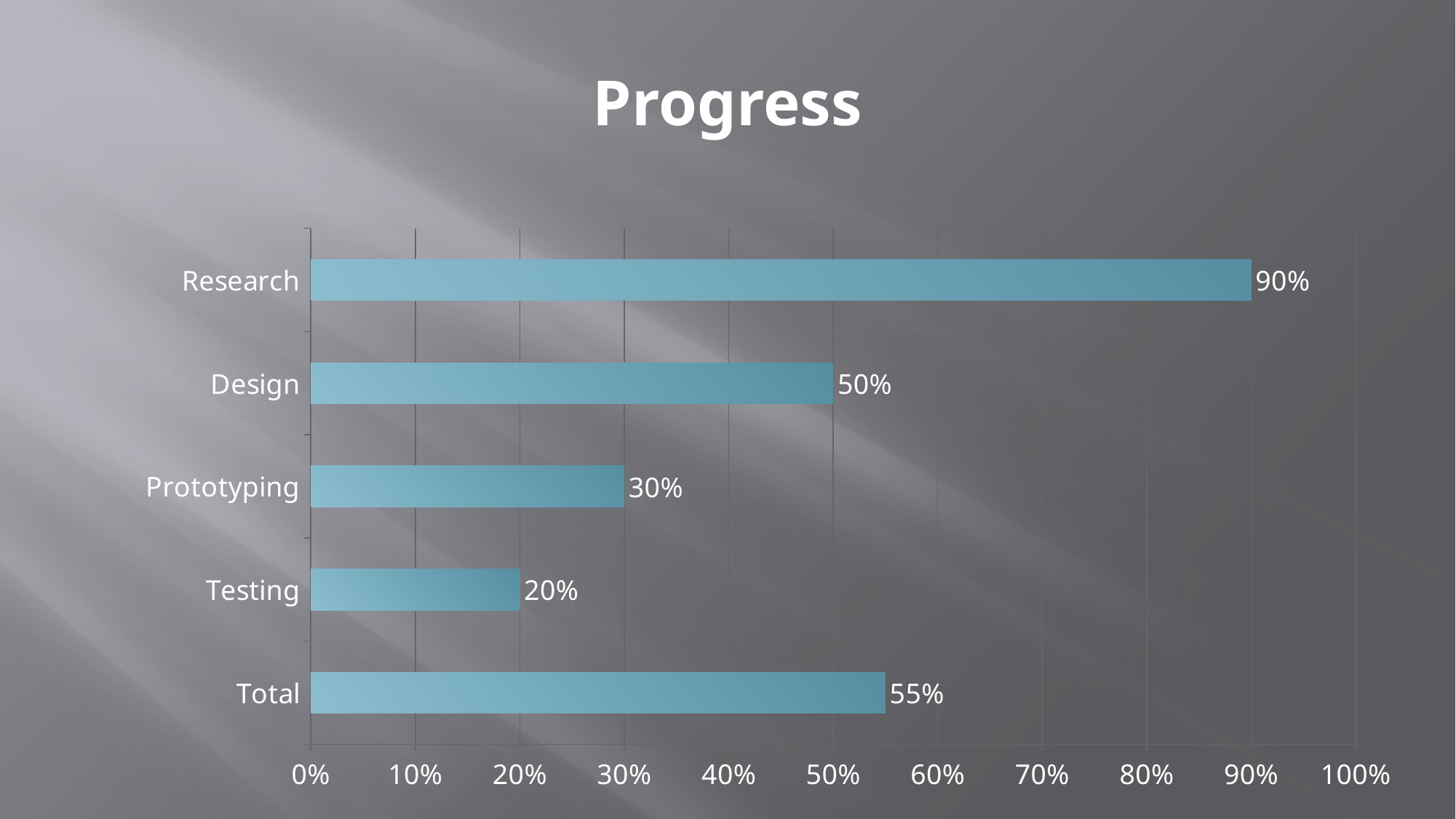
What is the value for Research? 90% What is the value for Prototyping? 30% How many categories are shown in the chart? 5 Which category has the highest value? Research What is the value for Testing? 20% Which is larger, the value for Total or the value for Design? Total What is the value for Design? 50% What is the value for Total? 55% Which category has the lowest value? Testing What is the title of the chart? Progress What is the difference between the values for Research and Design? 40% What kind of chart is shown on the slide? Bar chart